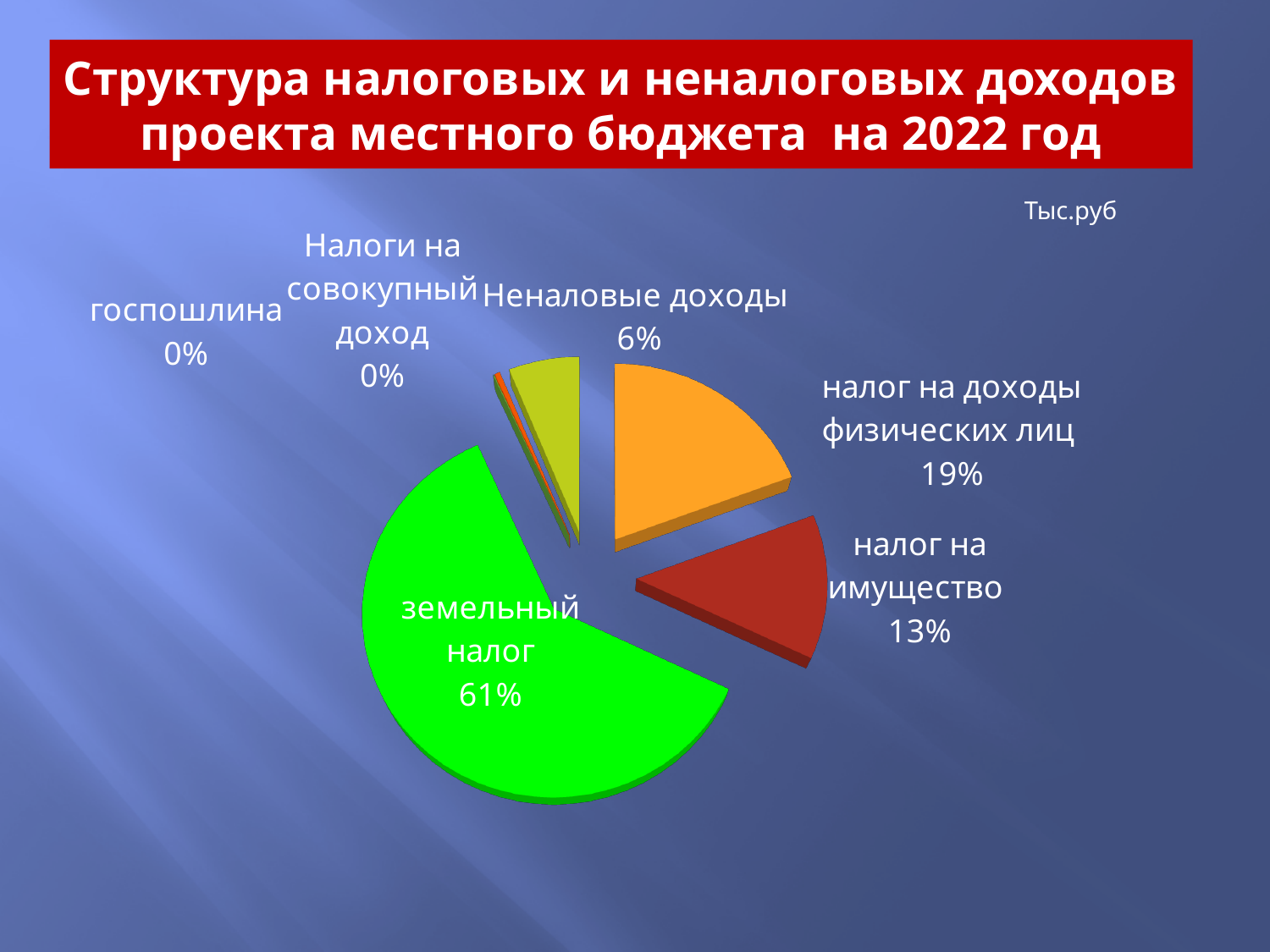
Which category has the largest share of the pie? земельный налог What percentage is shown for налог на имущество? 13% What is the difference in percentage points between налог на доходы физических лиц and налог на имущество? 6 Which is larger, налог на доходы физических лиц or налог на имущество? налог на доходы физических лиц What is the difference in percentage points between земельный налог and налог на доходы физических лиц? 42 What unit is indicated in the top right corner of the chart area? Тыс.руб What percentage is shown for Неналовые доходы? 6% How many categories are shown in the pie chart? 6 What percentage is shown for госпошлина? 0% What type of chart is shown on the slide? pie chart What share of the pie does земельный налог account for? 61% What percentage is shown for налог на доходы физических лиц? 19%